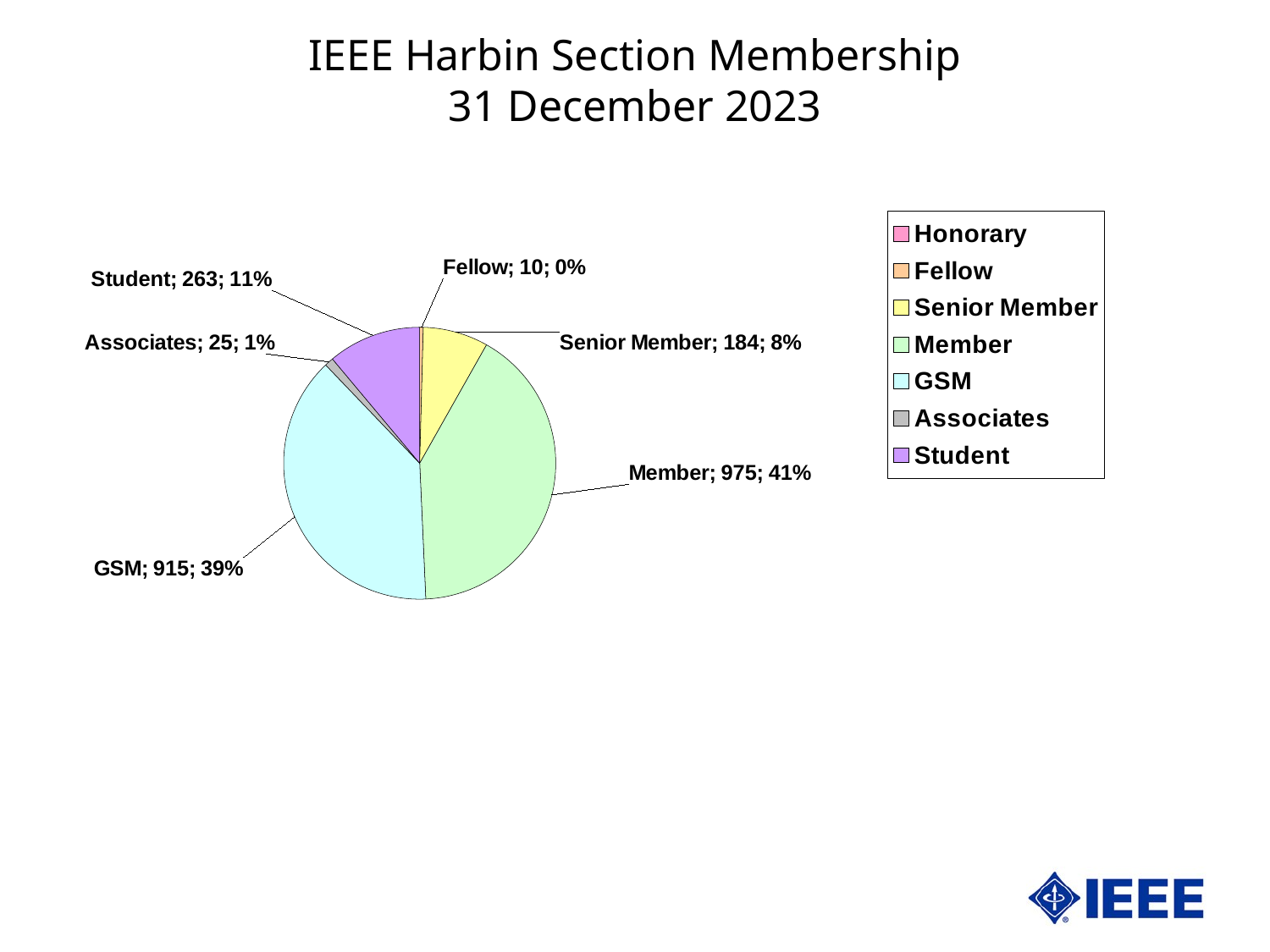
Which category has the largest slice of the pie? Member Which is larger, Student or Senior Member? Student How many entries does the legend list? 7 What percentage share does Associates have? 1% What is the difference between the Member and GSM values? 60 What is the title of the chart? IEEE Harbin Section Membership 31 December 2023 Which labelled category has the smallest value? Fellow How many members does the Member category have? 975 How many Senior Members are shown? 184 What type of chart is shown on the slide? pie chart What share of the pie does GSM represent? 39% What is the value for Student? 263